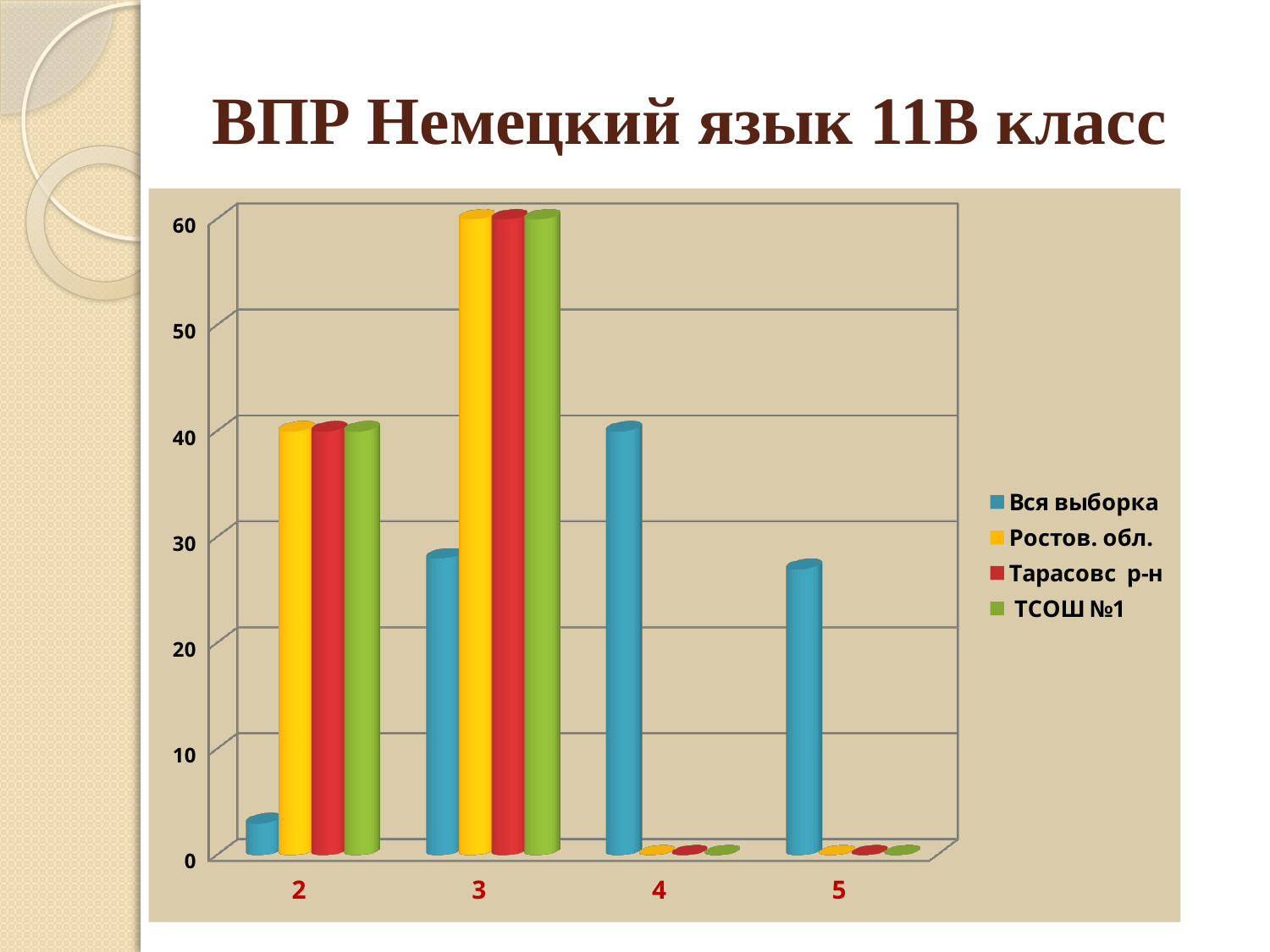
Which is larger in category 2: the value for Вся выборка or the value for Ростов. обл.? Ростов. обл. In which category is the value for Вся выборка lowest? 2 What is the value for Тарасовс р-н in category 5? 0 How many series does the legend list? 4 What is the value for ТСОШ №1 in category 2? 40 What kind of chart is shown on the slide? bar chart How many categories are shown on the x axis? 4 What is the title of the slide? ВПР Немецкий язык 11В класс Is the value for Вся выборка in category 3 greater or less than 30? less What is the value for Ростов. обл. in category 3? 60 What is the value for Вся выборка in category 4? 40 In which category is the value for Вся выборка highest? 4